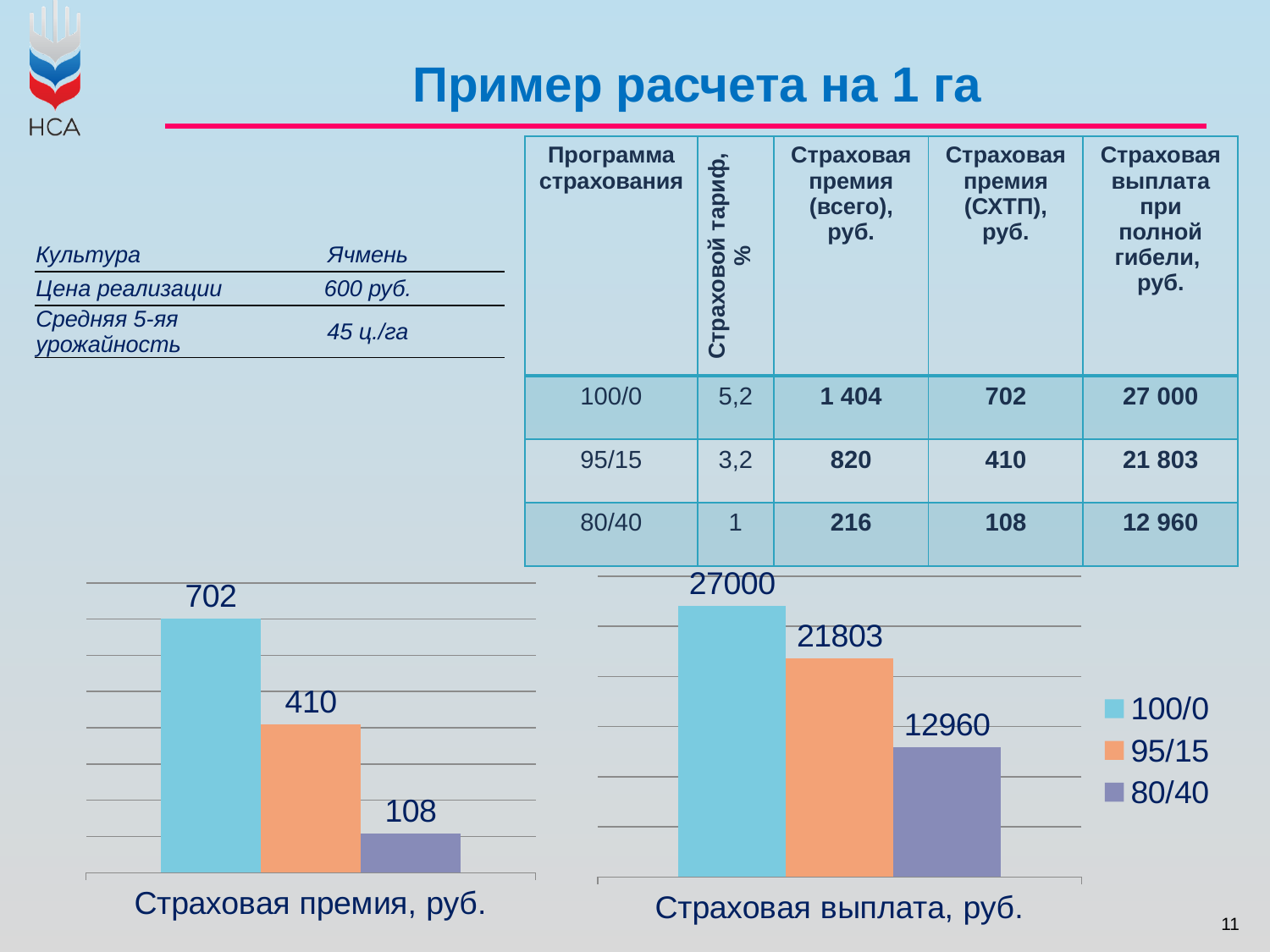
How many entries does the legend on the slide list? 3 In the chart titled "Страховая выплата, руб.", do the values rise or fall from left to right? fall In the chart titled "Страховая выплата, руб.", which program has the highest value? 100/0 What kind of chart is the chart titled "Страховая премия, руб."? bar chart In the chart titled "Страховая премия, руб.", which is larger, the value for 95/15 or the value for 80/40? 95/15 In the chart titled "Страховая премия, руб.", what is the difference between the values for 100/0 and 95/15? 292 In the chart titled "Страховая выплата, руб.", what is the value for 80/40? 12960 How many bars are in the chart titled "Страховая выплата, руб."? 3 In the chart titled "Страховая выплата, руб.", what is the value for 95/15? 21803 In the chart titled "Страховая премия, руб.", which program has the lowest value? 80/40 In the chart titled "Страховая премия, руб.", what is the value for 100/0? 702 In the chart titled "Страховая выплата, руб.", what is the difference between the values for 100/0 and 80/40? 14040